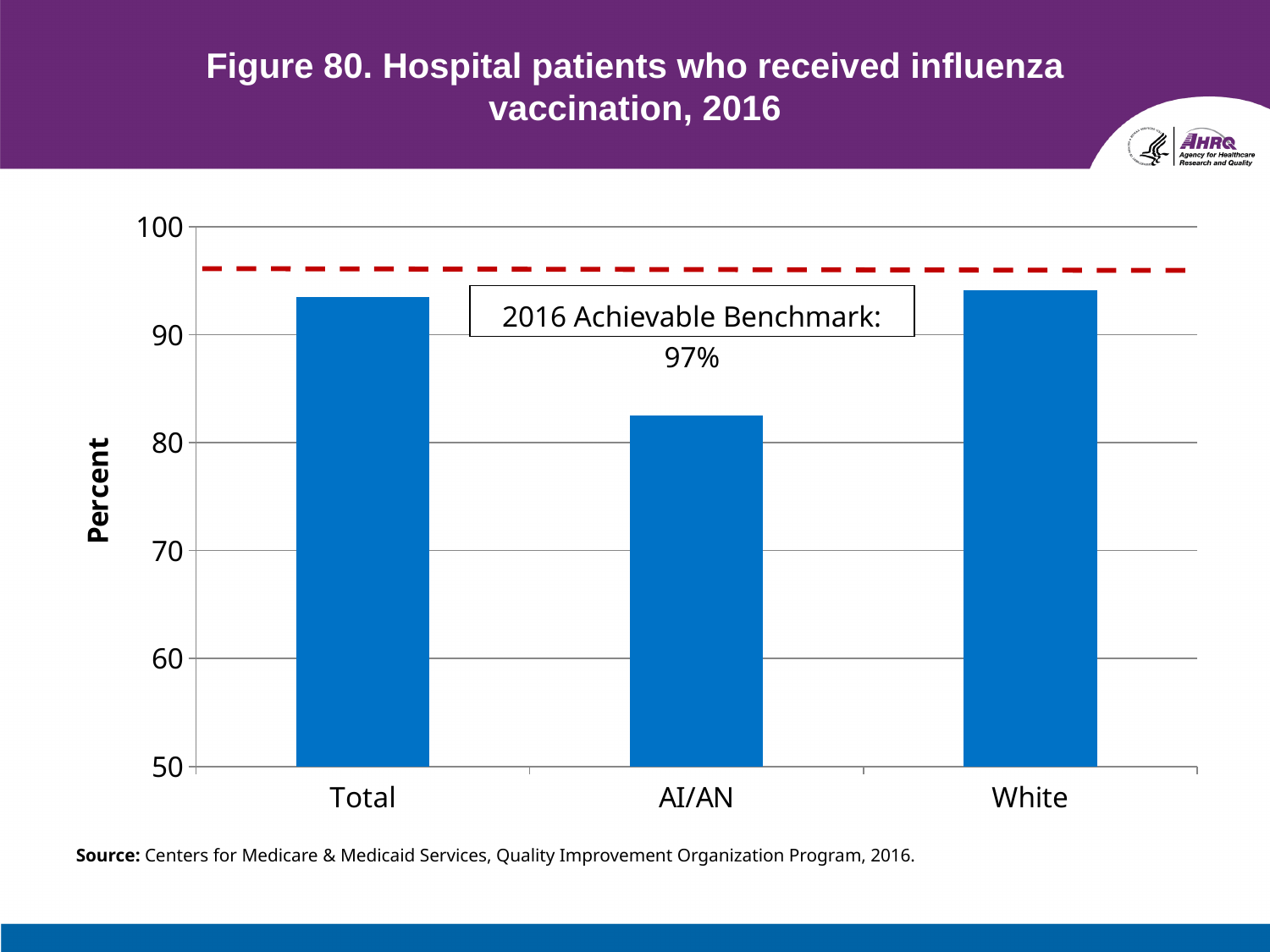
What kind of chart is shown on the slide? bar chart How many categories are shown on the x axis of the chart? 3 Which category has the lowest value in the chart? AI/AN What is the 2016 Achievable Benchmark shown on the chart? 97% Is the value for AI/AN greater or less than 90? less What is the title of the chart? Figure 80. Hospital patients who received influenza vaccination, 2016 Is the value for Total greater or less than 90? greater Is the value for AI/AN greater or less than 80? greater Which is larger, the value for Total or the value for AI/AN? Total What is the label of the y axis? Percent Which is larger, the value for White or the value for AI/AN? White